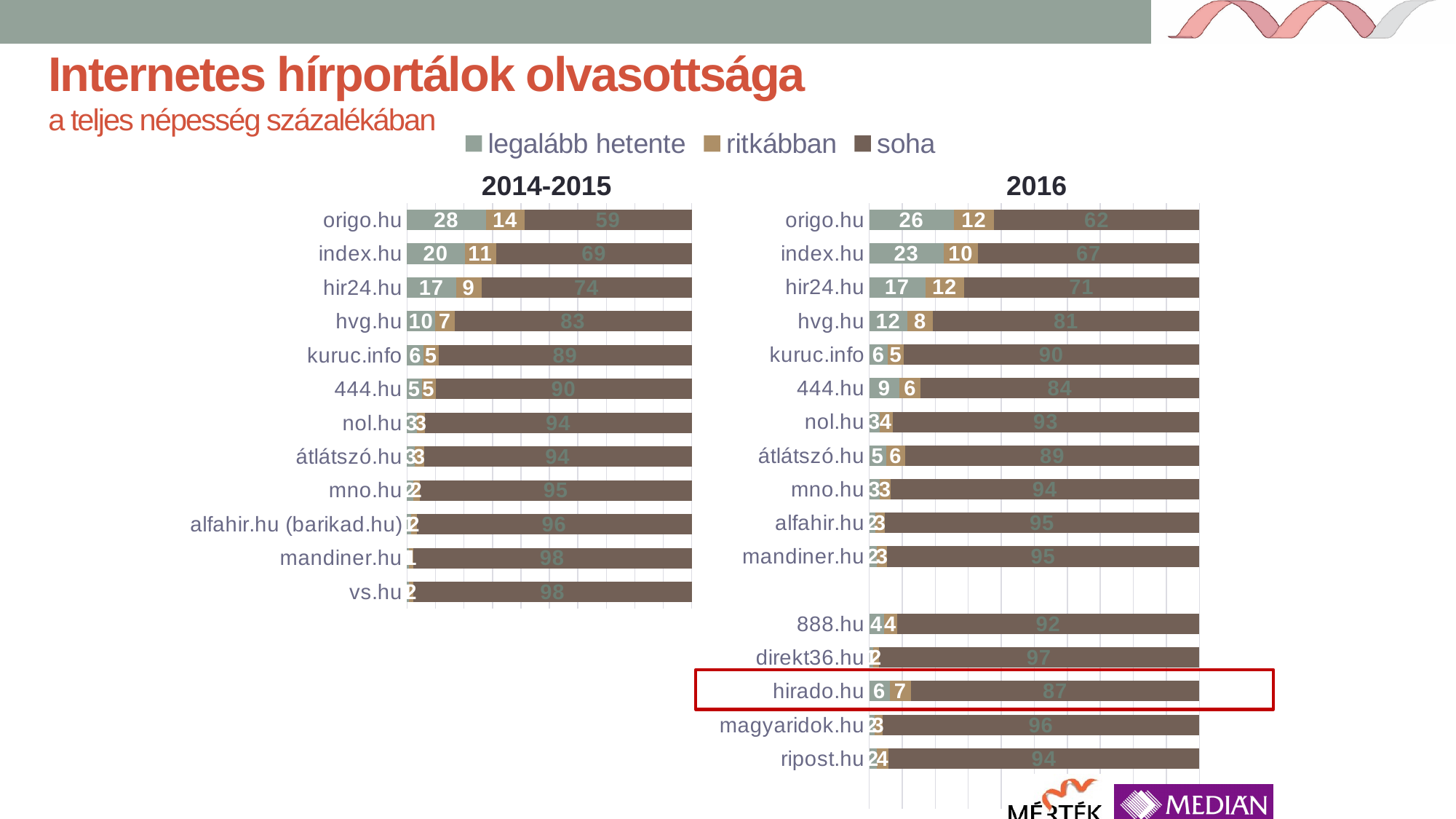
What kind of chart is the 2016 chart? Stacked bar chart In the 2016 chart, which portal has the lowest 'soha' value? origo.hu How many portals are listed in the 2014-2015 chart? 12 In the 2014-2015 chart, what is the 'soha' value for origo.hu? 59 In the 2016 chart, what is the 'ritkábban' value for hirado.hu? 7 In the 2016 chart, what is the total of the stacked bar for 444.hu? 99 In the 2014-2015 chart, which portal has the highest 'legalább hetente' value? origo.hu In the 2016 chart, what is the difference between the 'soha' values of index.hu and origo.hu? 5 How many portals are listed in the 2016 chart? 16 In the 2014-2015 chart, which is larger: the 'legalább hetente' value for hir24.hu or for hvg.hu? hir24.hu In the 2016 chart, what is the 'legalább hetente' value for index.hu? 23 How many series does the legend list? 3